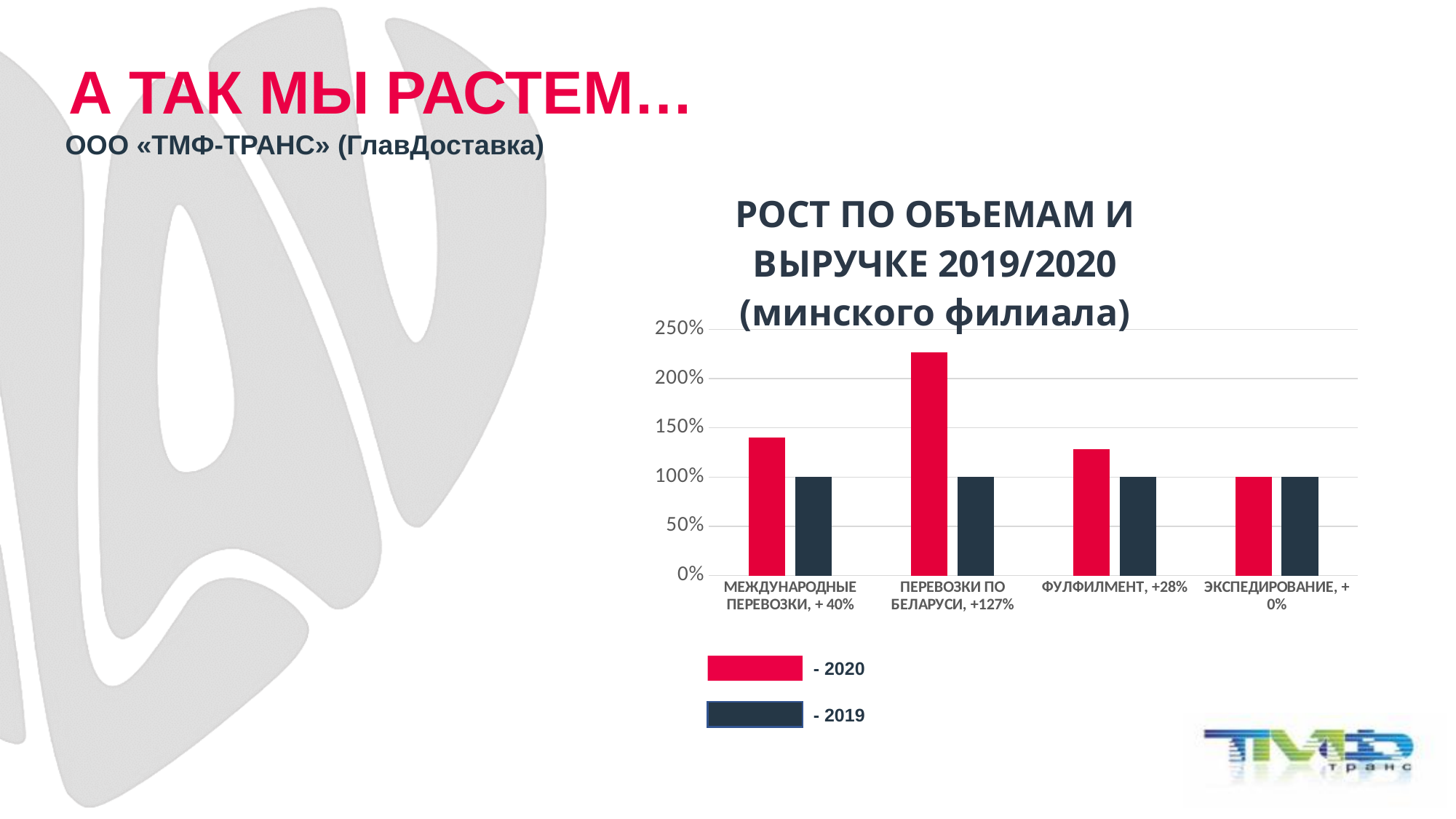
What is the 2019 value for ФУЛФИЛМЕНТ? 100% What is the 2020 value for ЭКСПЕДИРОВАНИЕ? 100% Which year does the red series in the legend represent? 2020 Which is larger: the 2020 value for МЕЖДУНАРОДНЫЕ ПЕРЕВОЗКИ or the 2020 value for ФУЛФИЛМЕНТ? МЕЖДУНАРОДНЫЕ ПЕРЕВОЗКИ Which category has the highest 2020 bar? ПЕРЕВОЗКИ ПО БЕЛАРУСИ Which category has the lowest 2020 bar? ЭКСПЕДИРОВАНИЕ Is the 2020 value for ПЕРЕВОЗКИ ПО БЕЛАРУСИ greater or less than 200%? greater What kind of chart is shown on the slide? Bar chart How many categories are shown on the x axis of the chart? 4 Is the 2020 value for ФУЛФИЛМЕНТ greater or less than 150%? less What growth percentage is printed in the category label for ПЕРЕВОЗКИ ПО БЕЛАРУСИ? +127% How many series does the chart's legend list? 2